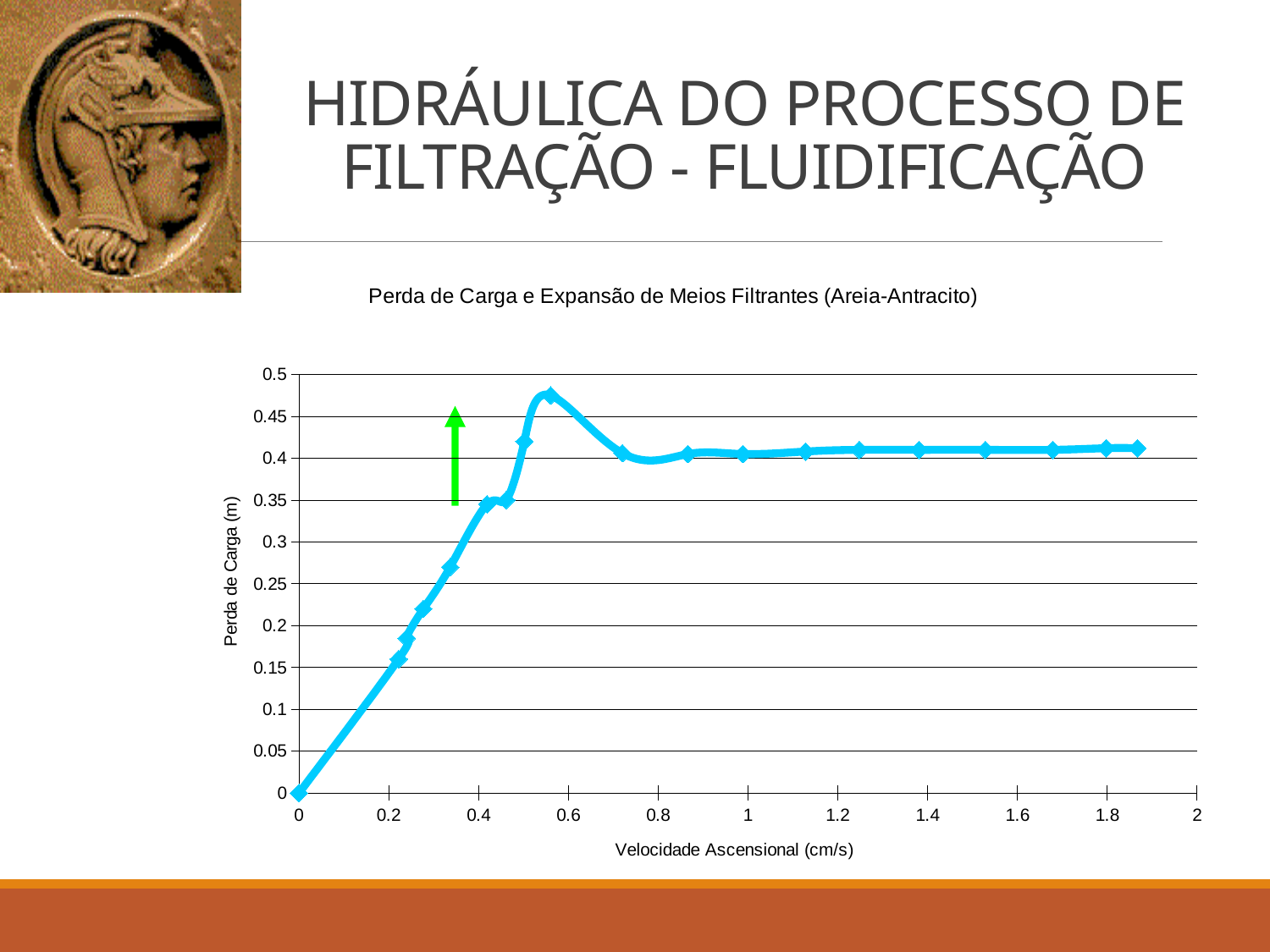
What is the title of the chart? Perda de Carga e Expansão de Meios Filtrantes (Areia-Antracito) Is the Perda de Carga value at a Velocidade Ascensional of 0.2 cm/s greater or less than 0.1? greater Does the Perda de Carga rise or fall as Velocidade Ascensional increases from 0 to 0.5 cm/s? Rises Is the Perda de Carga value at a Velocidade Ascensional of 1 cm/s greater or less than 0.35? greater Which is larger: the Perda de Carga at 0.2 cm/s or at 1.8 cm/s? 1.8 cm/s Is the peak value of Perda de Carga on the curve greater or less than 0.45? greater What kind of chart is shown on the slide? Line chart What is the Perda de Carga value at a Velocidade Ascensional of 0 cm/s? 0 What is the label of the x axis of the chart? Velocidade Ascensional (cm/s)